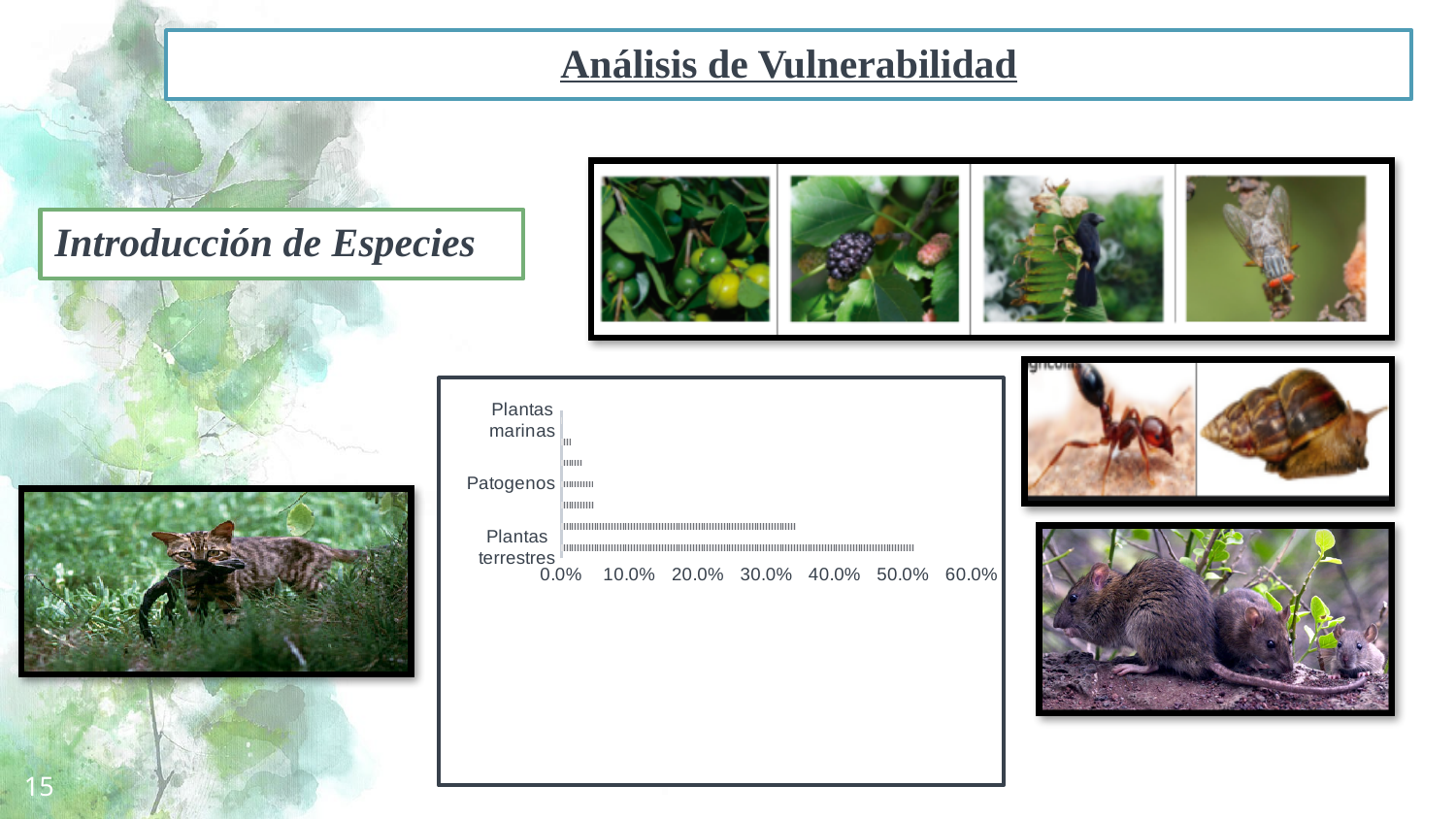
What is the highest value shown on the horizontal axis of the chart? 60.0% Is the value for Patogenos greater or less than 10.0%? less How many bars are plotted in the chart? 7 Which category has the shortest bar in the chart? Plantas marinas Which is larger, the value for Plantas terrestres or the value for Patogenos? Plantas terrestres Which category has the longest bar in the chart? Plantas terrestres Is the value for Plantas terrestres greater or less than 40.0%? greater Is the value for Plantas terrestres greater or less than 30.0%? greater What kind of chart is shown on the slide? bar chart Which is larger, the value for Patogenos or the value for Plantas marinas? Patogenos